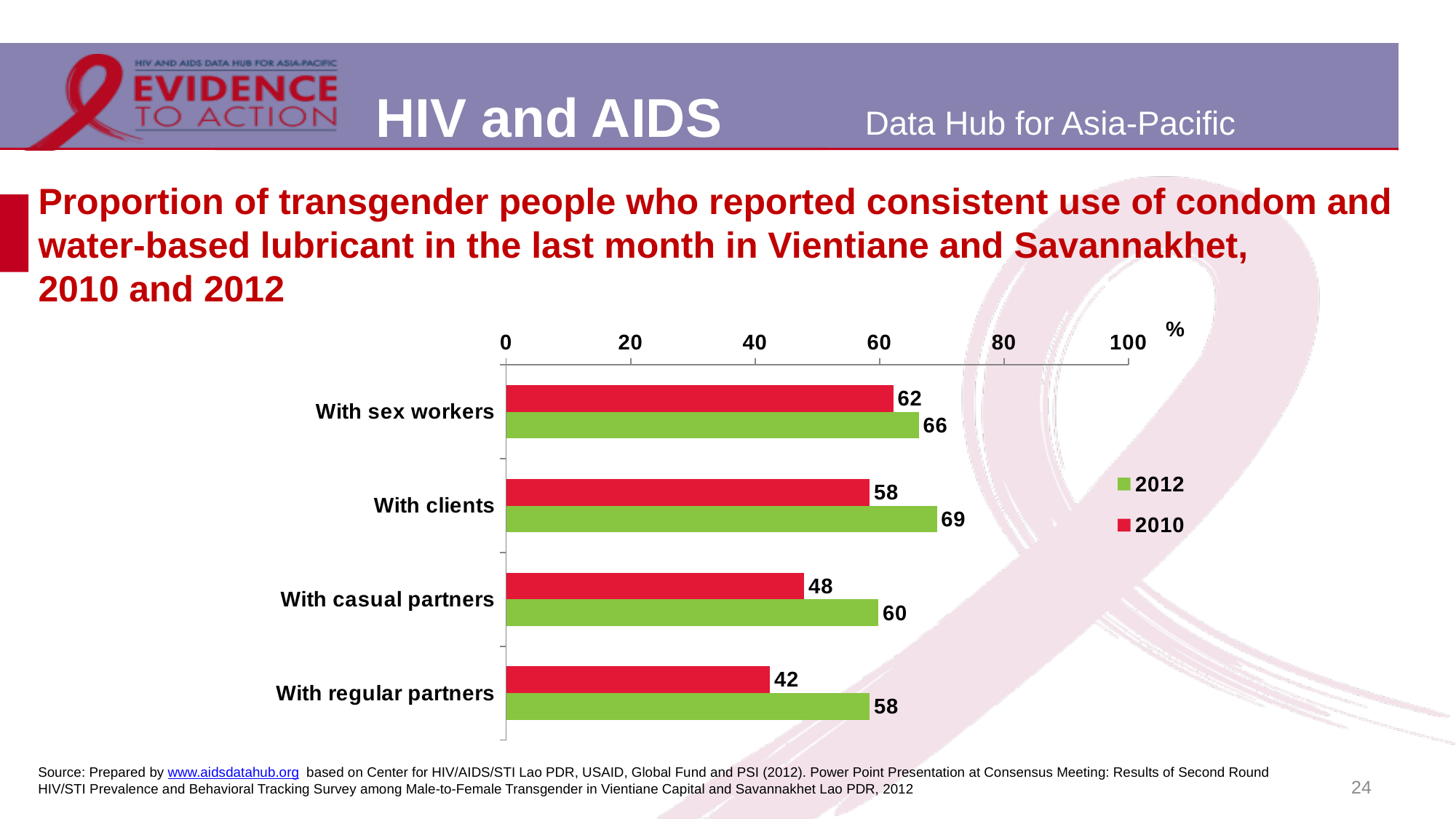
What is the difference between the 2012 and 2010 values for 'With regular partners'? 16 What is the 2010 value for 'With regular partners'? 42 What is the 2010 value for 'With casual partners'? 48 How many series does the legend list? 2 What is the 2012 value for 'With clients'? 69 Which is larger for 'With clients': the 2010 value or the 2012 value? 2012 Which category has the lowest 2010 value? With regular partners What kind of chart is shown on the slide? Bar chart What is the 2012 value for 'With sex workers'? 66 What is the difference between the 2012 and 2010 values for 'With casual partners'? 12 How many categories are shown on the chart? 4 Which category has the highest 2012 value? With clients